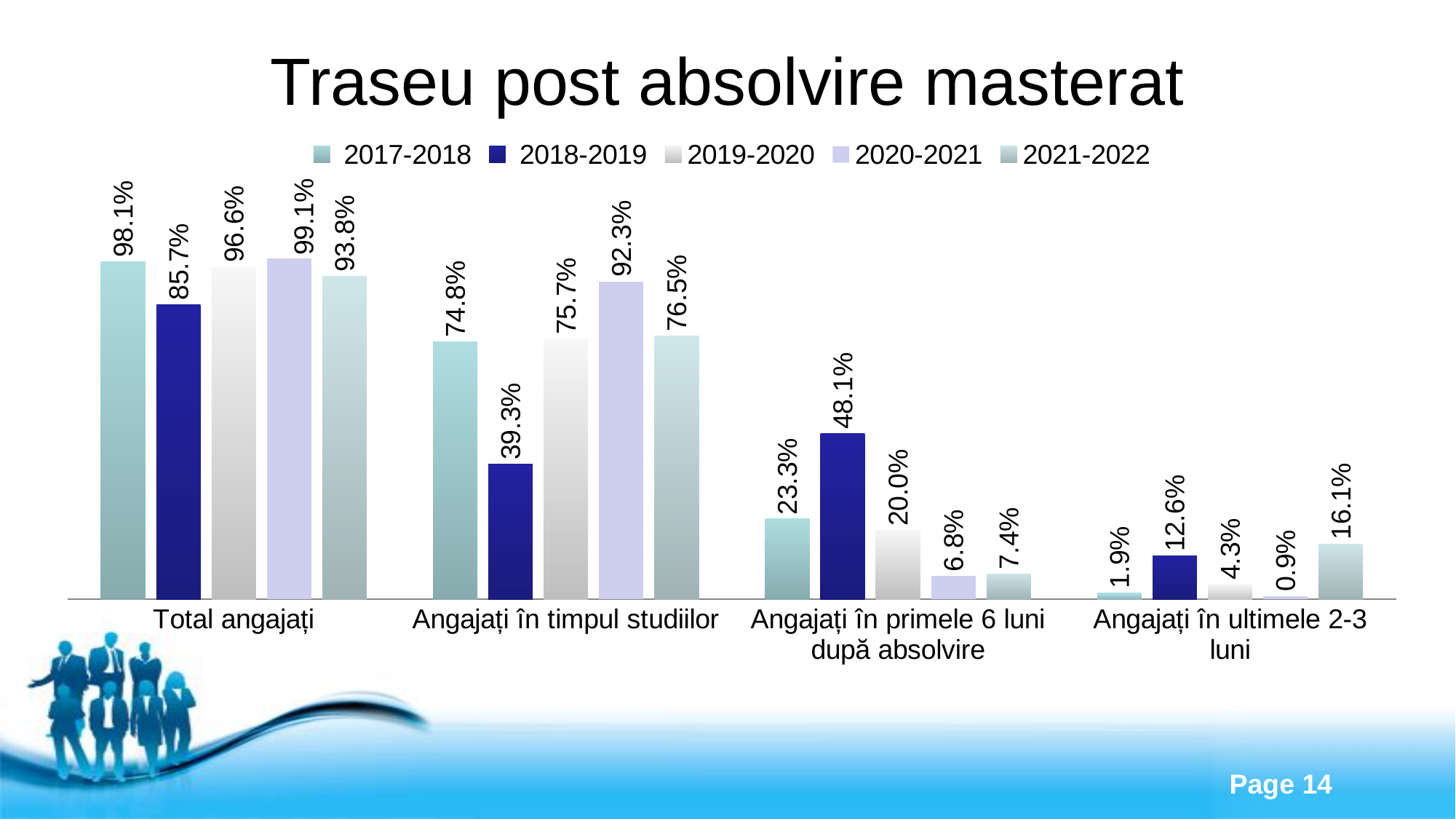
What kind of chart is shown on the slide? Bar chart Which series has the highest value in the "Angajați în primele 6 luni după absolvire" category? 2018-2019 What is the title of the chart? Traseu post absolvire masterat What is the value for 2020-2021 in the "Angajați în timpul studiilor" category? 92.3% What is the difference between the 2018-2019 and 2019-2020 values in the "Angajați în primele 6 luni după absolvire" category? 28.1% What is the value for 2021-2022 in the "Angajați în ultimele 2-3 luni" category? 16.1% How many series does the legend list? 5 What is the value for 2018-2019 in the "Total angajați" category? 85.7% Which series has the lowest value in the "Angajați în ultimele 2-3 luni" category? 2020-2021 In the "Total angajați" category, which is larger: the 2017-2018 value or the 2021-2022 value? 2017-2018 What is the difference between the 2020-2021 and 2018-2019 values in the "Angajați în timpul studiilor" category? 53.0% How many categories are shown on the x axis? 4